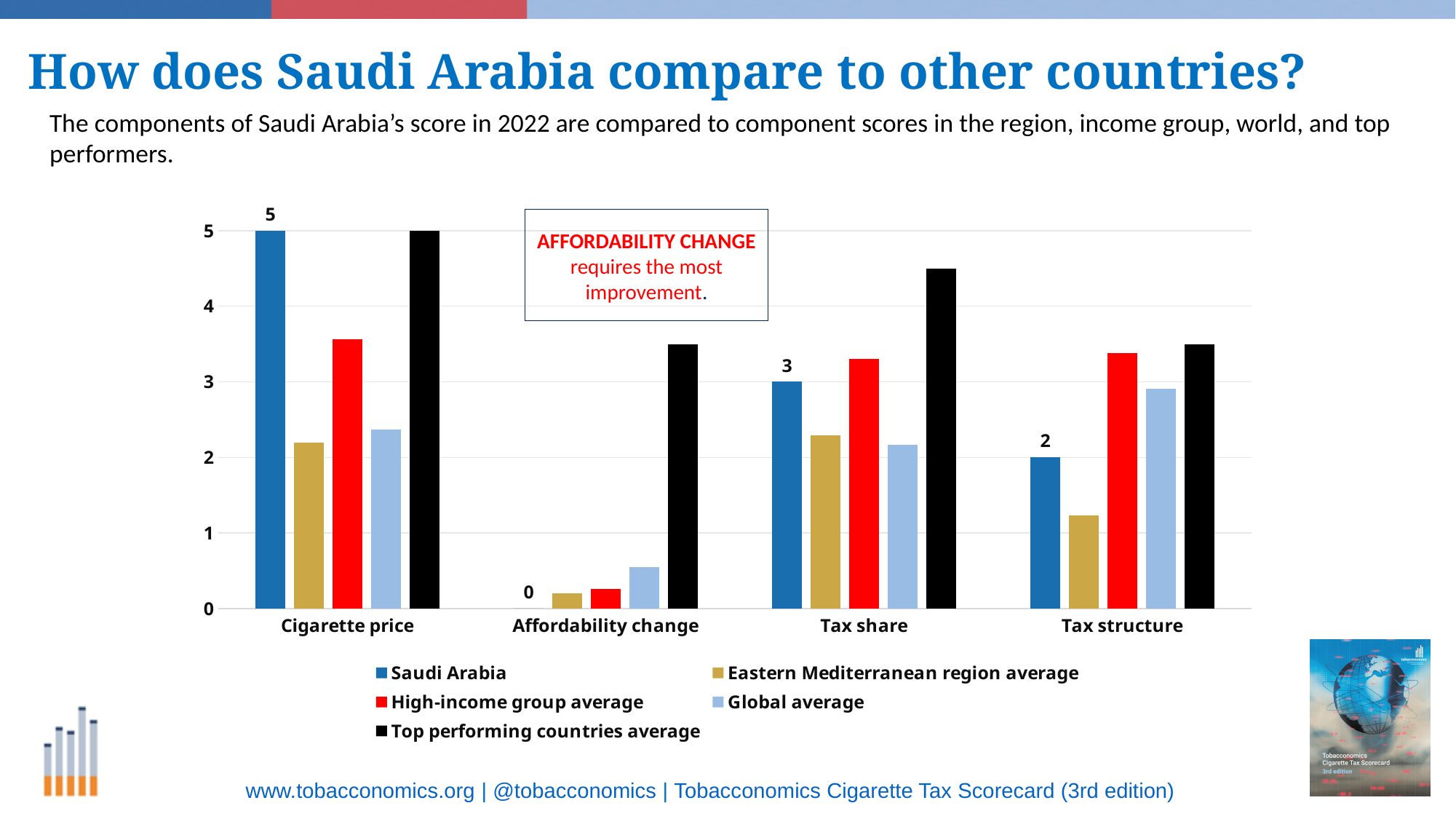
How many series does the legend list? 5 For Tax structure, which is larger: the Saudi Arabia score or the High-income group average? High-income group average For which component does Saudi Arabia have its highest score? Cigarette price What is the Saudi Arabia score for Tax structure? 2 What kind of chart is shown on the slide? bar chart What is the Saudi Arabia score for Cigarette price? 5 For which component does Saudi Arabia have its lowest score? Affordability change What is the difference between Saudi Arabia's Cigarette price score and its Tax structure score? 3 Is the Top performing countries average for Affordability change greater or less than 3? greater What is the Saudi Arabia score for Affordability change? 0 What is the Saudi Arabia score for Tax share? 3 How many score components are shown on the x axis? 4